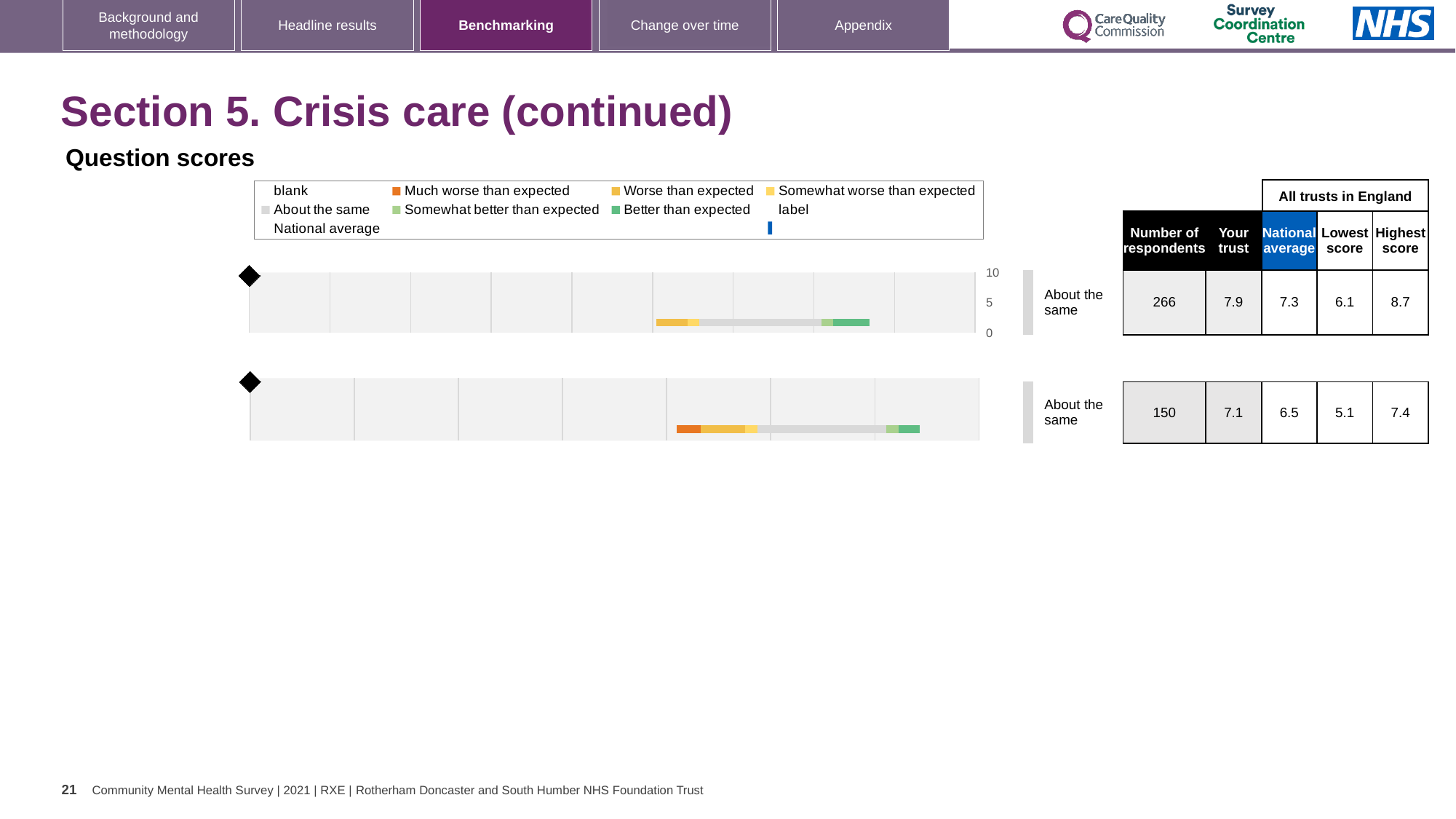
In the top chart's table, what is the highest score among all trusts in England? 8.7 For the top chart, what is the difference between the 'Your trust' score and the national average? 0.6 What kind of chart is used to show the question scores on this slide? Bar chart In the bottom chart's table, what is the lowest score among all trusts in England? 5.1 For the bottom chart, what is the difference between the highest score and the lowest score among all trusts in England? 2.3 In the top chart's table, what is the number of respondents? 266 Which chart has the higher 'Your trust' score, the top chart or the bottom chart? Top chart What benchmark category label is shown next to the bottom chart? About the same In the top chart's table, what is the national average score? 7.3 In the top chart's table, what is the 'Your trust' score? 7.9 In the bottom chart's table, what is the 'Your trust' score? 7.1 In the bottom chart's table, what is the number of respondents? 150